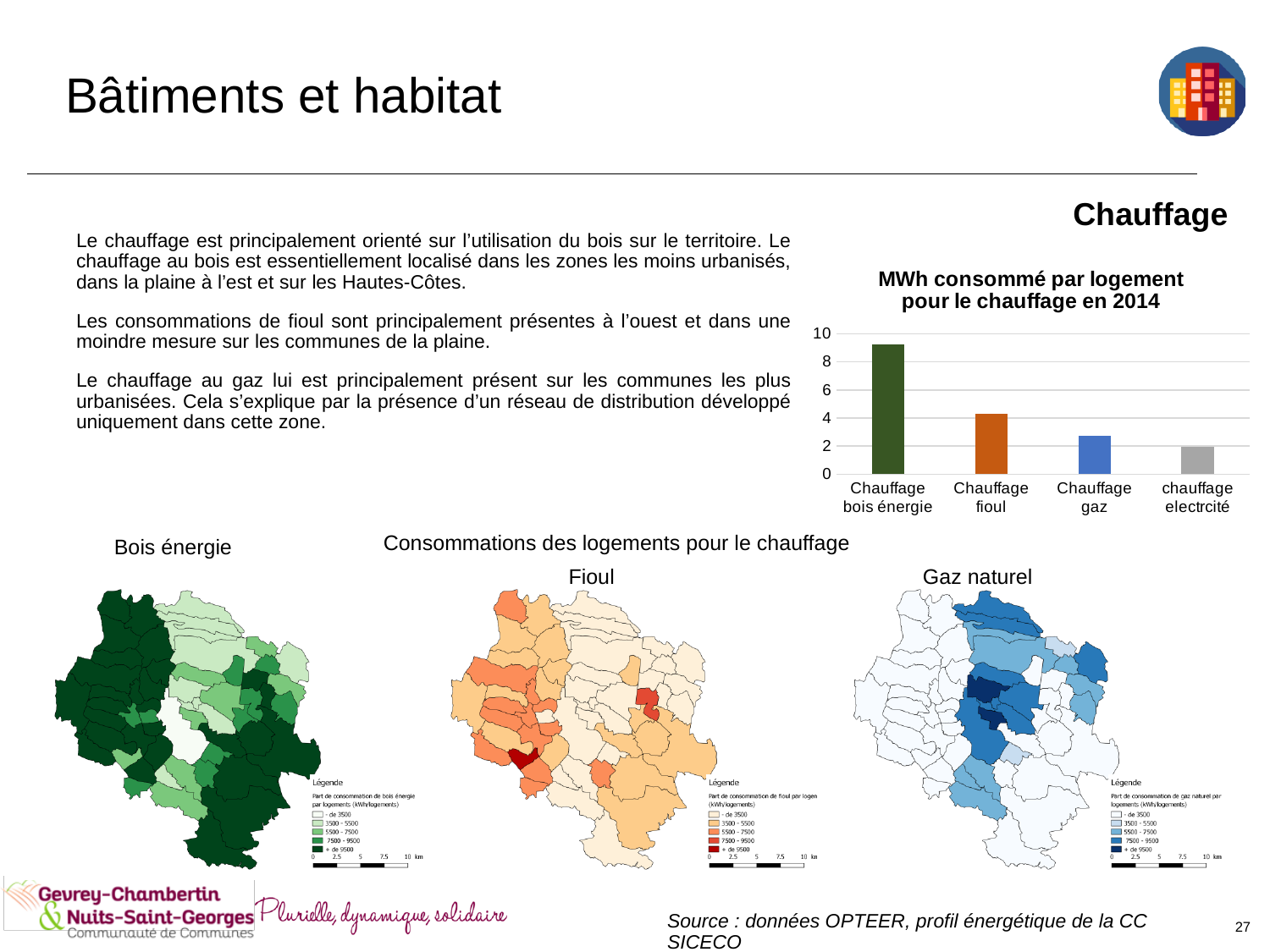
Which category has the highest value in the chart 'MWh consommé par logement pour le chauffage en 2014'? Chauffage bois énergie In the chart 'MWh consommé par logement pour le chauffage en 2014', which is larger: Chauffage fioul or Chauffage gaz? Chauffage fioul What is the title of the bar chart on the slide? MWh consommé par logement pour le chauffage en 2014 In the chart 'MWh consommé par logement pour le chauffage en 2014', which is larger: Chauffage bois énergie or Chauffage fioul? Chauffage bois énergie Which category has the lowest value in the chart 'MWh consommé par logement pour le chauffage en 2014'? chauffage electrcité In the chart 'MWh consommé par logement pour le chauffage en 2014', is the value for Chauffage gaz greater or less than 4? less In the chart 'MWh consommé par logement pour le chauffage en 2014', is the value for Chauffage bois énergie greater or less than 8? greater What kind of chart is 'MWh consommé par logement pour le chauffage en 2014'? bar chart How many categories are shown in the chart 'MWh consommé par logement pour le chauffage en 2014'? 4 Do the values in the chart 'MWh consommé par logement pour le chauffage en 2014' rise or fall from left to right along the x axis? fall In the chart 'MWh consommé par logement pour le chauffage en 2014', is the value for Chauffage fioul greater or less than 6? less